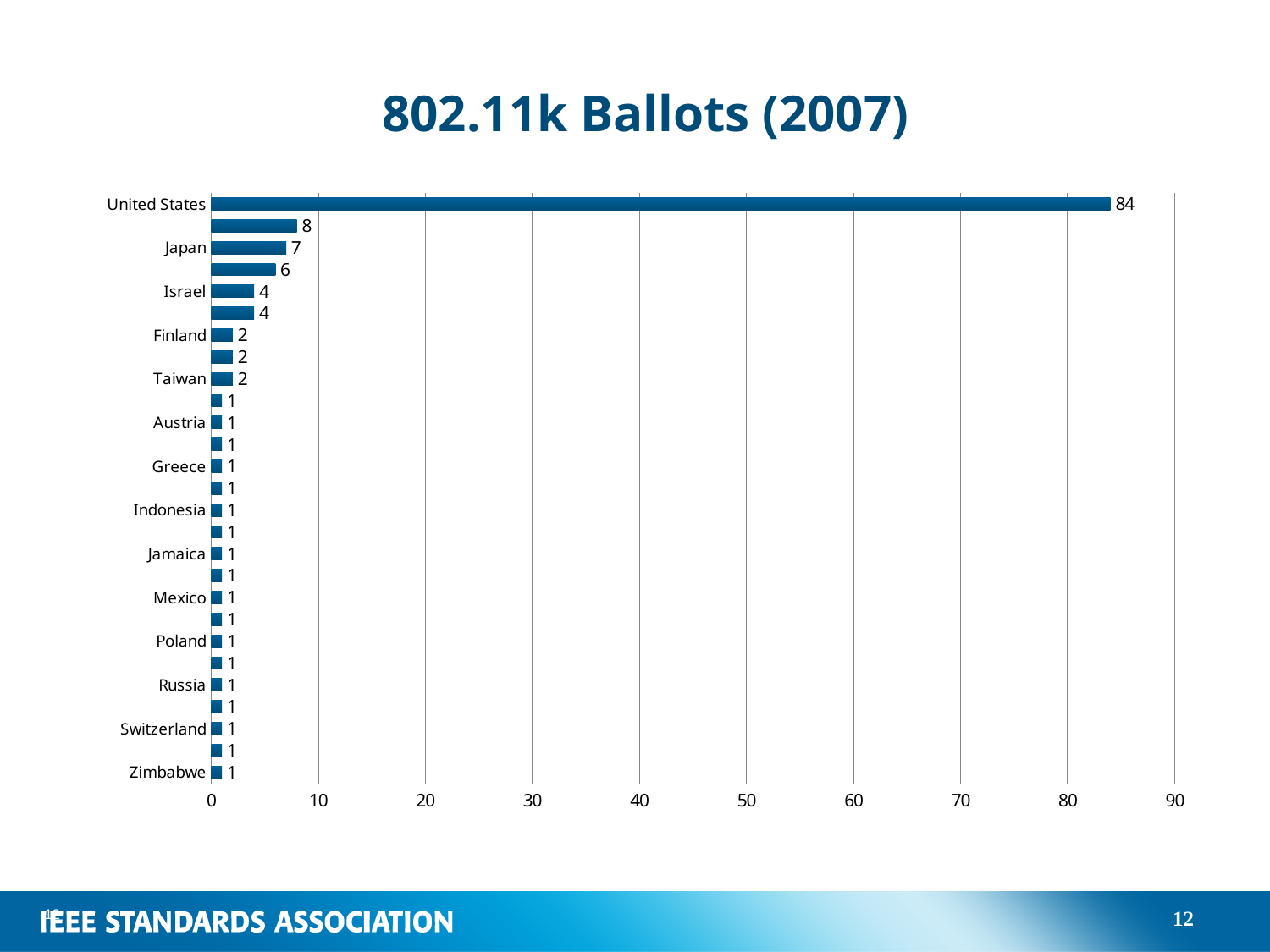
What is the value for Israel? 4 Is the value for United States greater or less than 80? greater Which country has the highest number of ballots? United States What is the difference between the values for United States and Japan? 77 Which is larger, the value for Japan or the value for Taiwan? Japan What is the difference between the values for Japan and Israel? 3 What kind of chart is shown on the slide? Bar chart What is the value for Finland? 2 What is the title of the chart? 802.11k Ballots (2007) What is the value for United States? 84 What is the value for Japan? 7 What is the value for Switzerland? 1